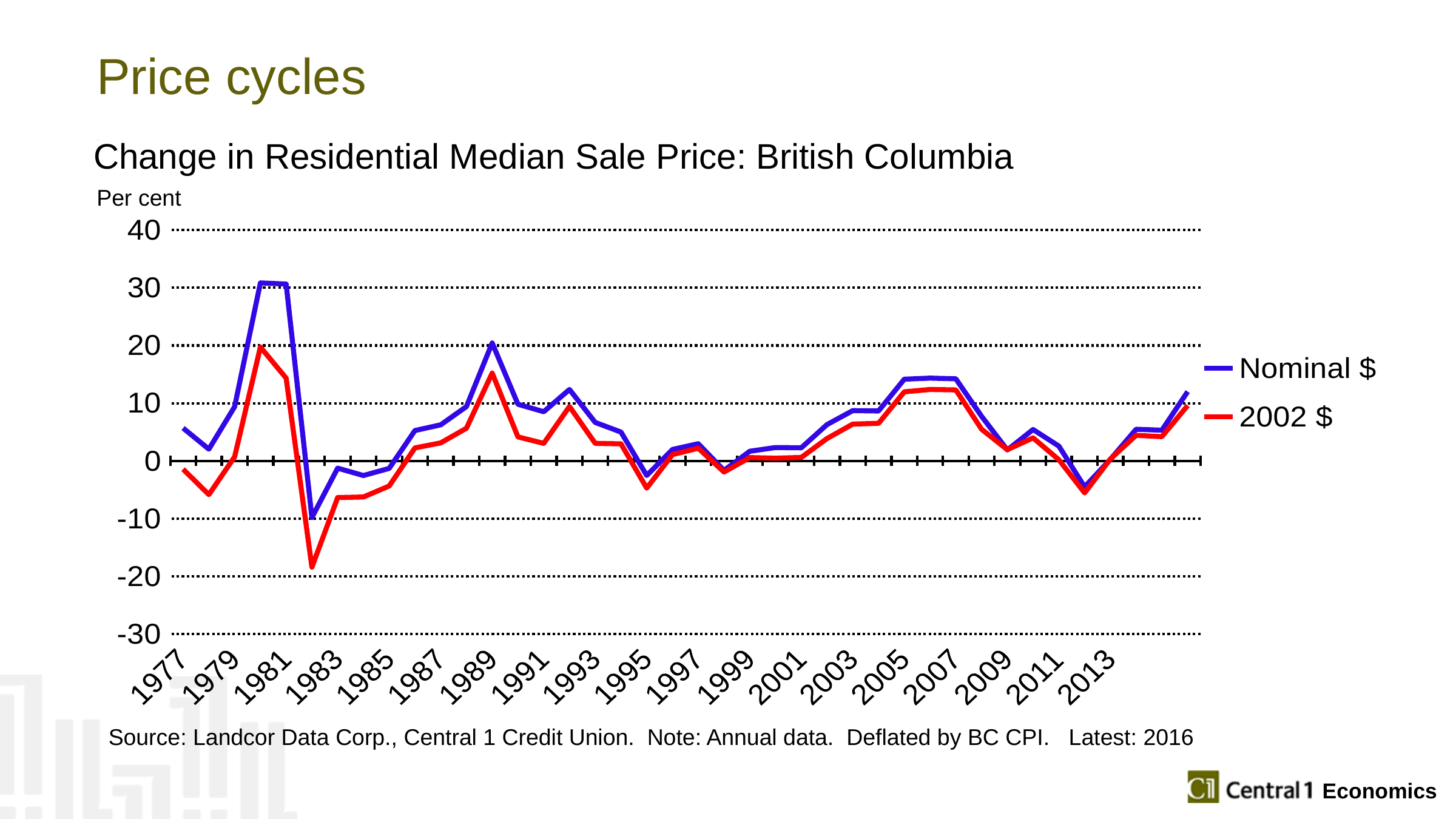
Is the value for Nominal $ in 1980 greater or less than 20? greater What kind of chart is shown on the slide? line chart In which year does the 2002 $ series reach its lowest value? 1982 Is the value for 2002 $ in 1982 greater or less than -10? less In which year does the 2002 $ series reach its highest value? 1980 What unit is shown on the vertical axis? Per cent In which year does the Nominal $ series reach its lowest value? 1982 In 1980, which series has the higher value, Nominal $ or 2002 $? Nominal $ How many series does the legend list? 2 Is the value for Nominal $ in 1989 greater or less than 10? greater What are the two series named in the legend? Nominal $ and 2002 $ Does the Nominal $ series rise or fall between 2001 and 2005? rise